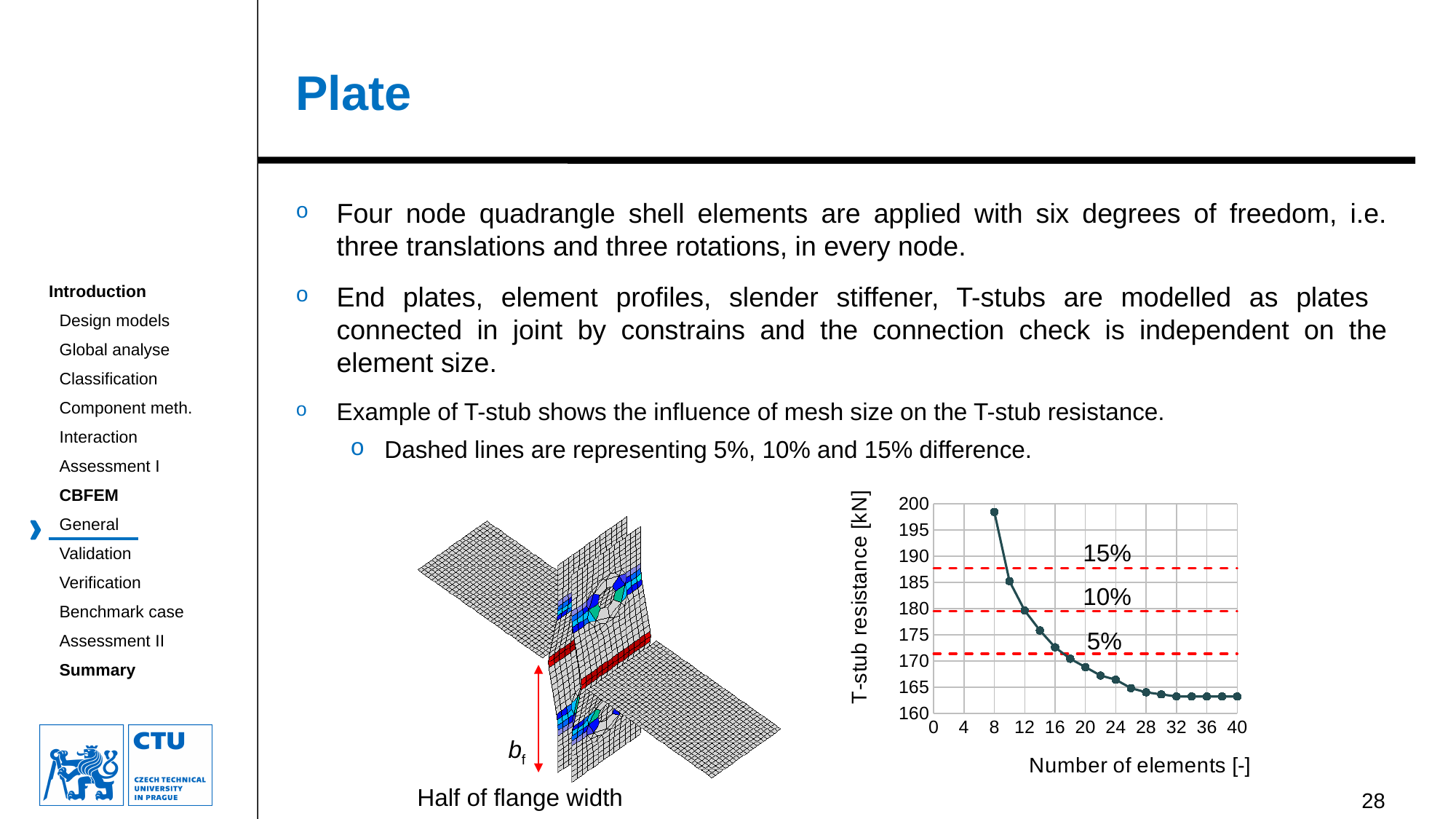
Is the T-stub resistance at 12 elements greater or less than 175? greater At which number of elements is the plotted T-stub resistance highest? 8 How many dashed horizontal lines are drawn on the chart? 3 What is the label of the y axis of the chart? T-stub resistance [kN] Is the T-stub resistance at 40 elements greater or less than 165? less What is the label of the x axis of the chart? Number of elements [-] Is the T-stub resistance at 20 elements greater or less than 170? less What is the highest value shown on the y axis of the chart? 200 Which is larger, the T-stub resistance at 10 elements or at 16 elements? 10 elements What kind of chart is shown on the right of the slide? line chart Do the plotted T-stub resistance values rise or fall as the number of elements increases? fall